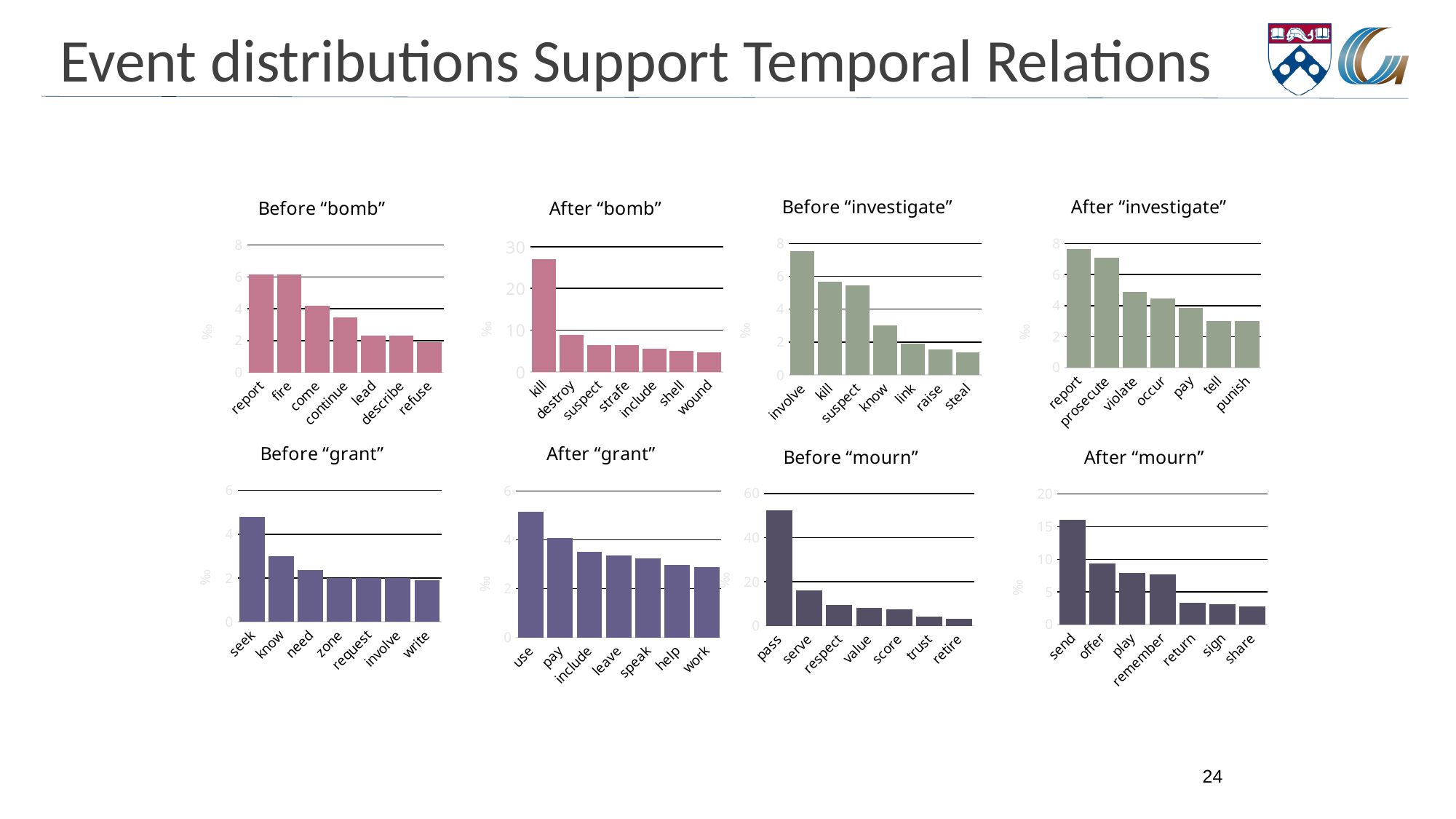
In the "Before "mourn"" chart, do the values rise or fall from left to right along the x axis? fall How many categories are shown in the "Before "grant"" chart? 7 In the "After "grant"" chart, which category has the highest value? use In the "Before "grant"" chart, is the value for seek greater or less than 4? greater In the "Before "investigate"" chart, is the value for involve greater or less than 6? greater How many charts are shown on the slide? 8 In the "After "mourn"" chart, is the value for send greater or less than 10? greater In the "Before "investigate"" chart, which category has the highest value? involve What kind of chart is the "After "bomb"" chart? bar chart In the "After "bomb"" chart, which category has the highest value? kill In the "Before "mourn"" chart, which is larger, the value for pass or the value for serve? pass